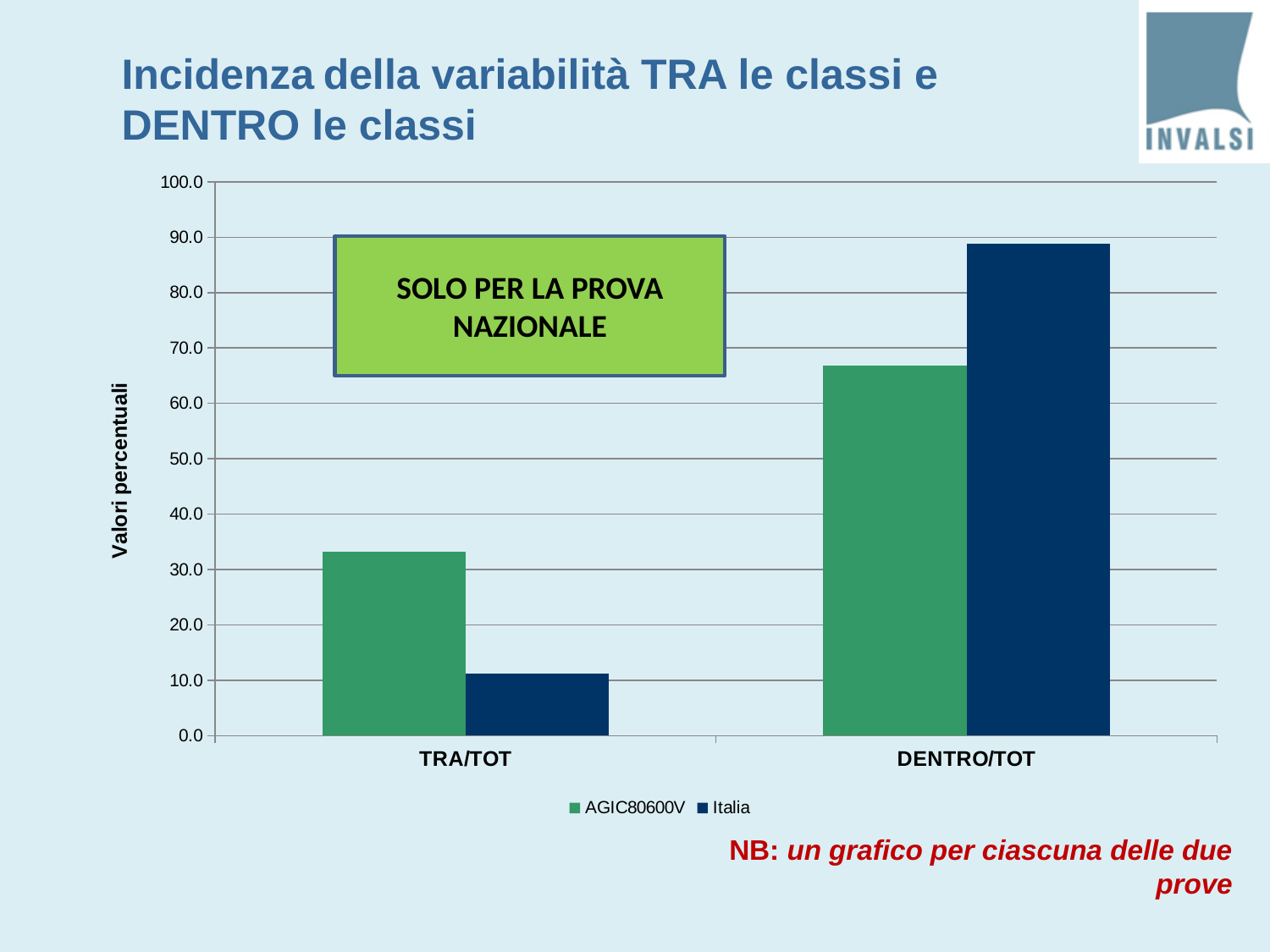
Is the value for AGIC80600V in TRA/TOT greater or less than 30.0? greater Is the value for AGIC80600V in DENTRO/TOT greater or less than 70.0? less How many categories are shown on the x axis? 2 In the DENTRO/TOT category, which series has the larger value, AGIC80600V or Italia? Italia Which series does the green bar represent? AGIC80600V Is the value for Italia in DENTRO/TOT greater or less than 80.0? greater What is the label of the y axis? Valori percentuali How many series does the legend list? 2 Which bar is the tallest in the chart? Italia in DENTRO/TOT In the TRA/TOT category, which series has the larger value, AGIC80600V or Italia? AGIC80600V What kind of chart is shown on the slide? bar chart